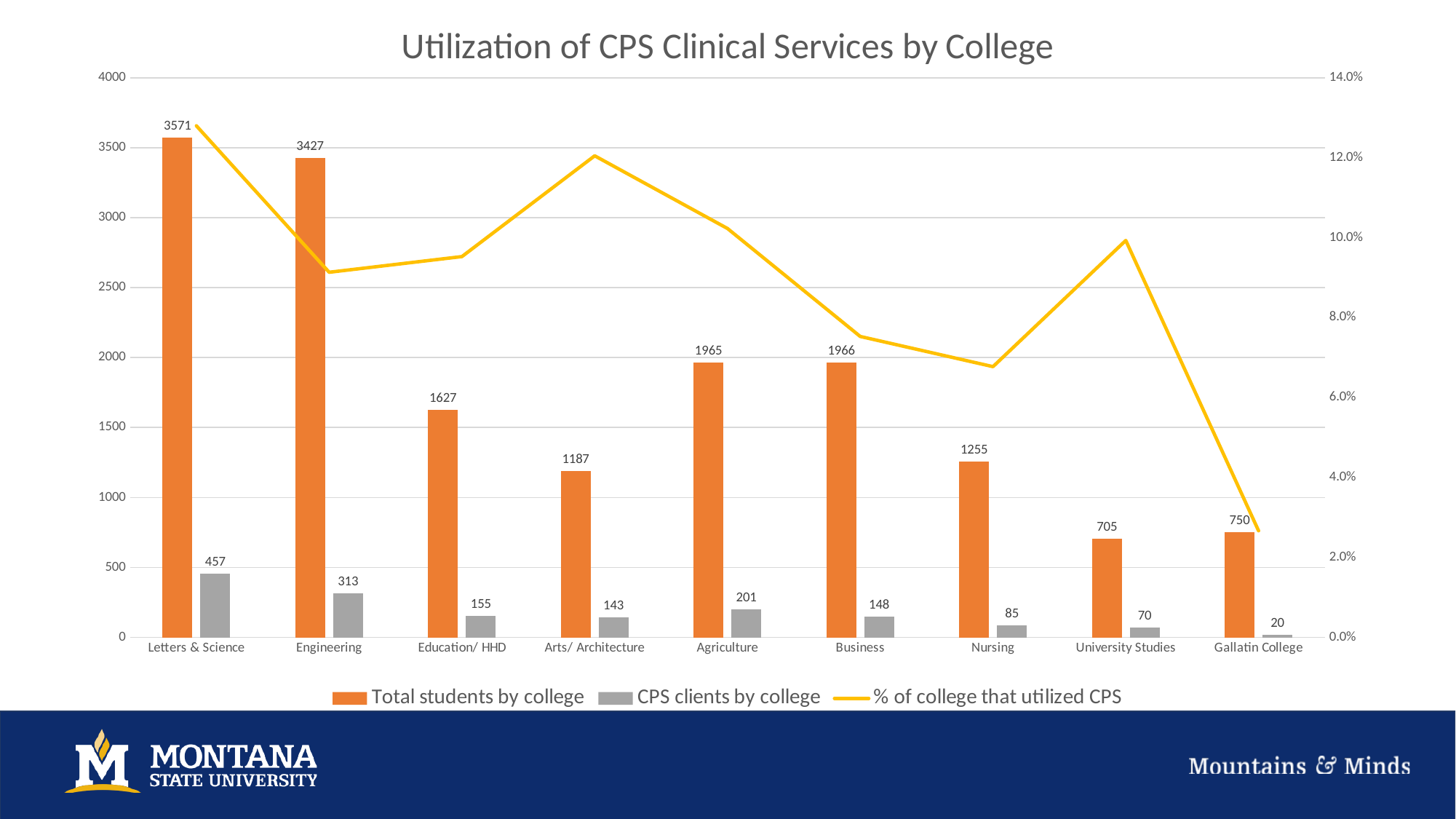
How many colleges are shown on the x axis? 9 What kind of chart is shown on the slide? Bar chart with a line series Which college has the highest Total students by college? Letters & Science Is the % of college that utilized CPS for Arts/ Architecture greater or less than 10.0%? greater Which college has the lowest number of CPS clients by college? Gallatin College How many series does the legend list? 3 Which series is plotted as a line rather than bars? % of college that utilized CPS Is the % of college that utilized CPS for Gallatin College greater or less than 4.0%? less What is the difference in Total students by college between Letters & Science and Engineering? 144 How many CPS clients by college are shown for Agriculture? 201 Which has more CPS clients by college, Letters & Science or Engineering? Letters & Science What is the value of Total students by college for Engineering? 3427